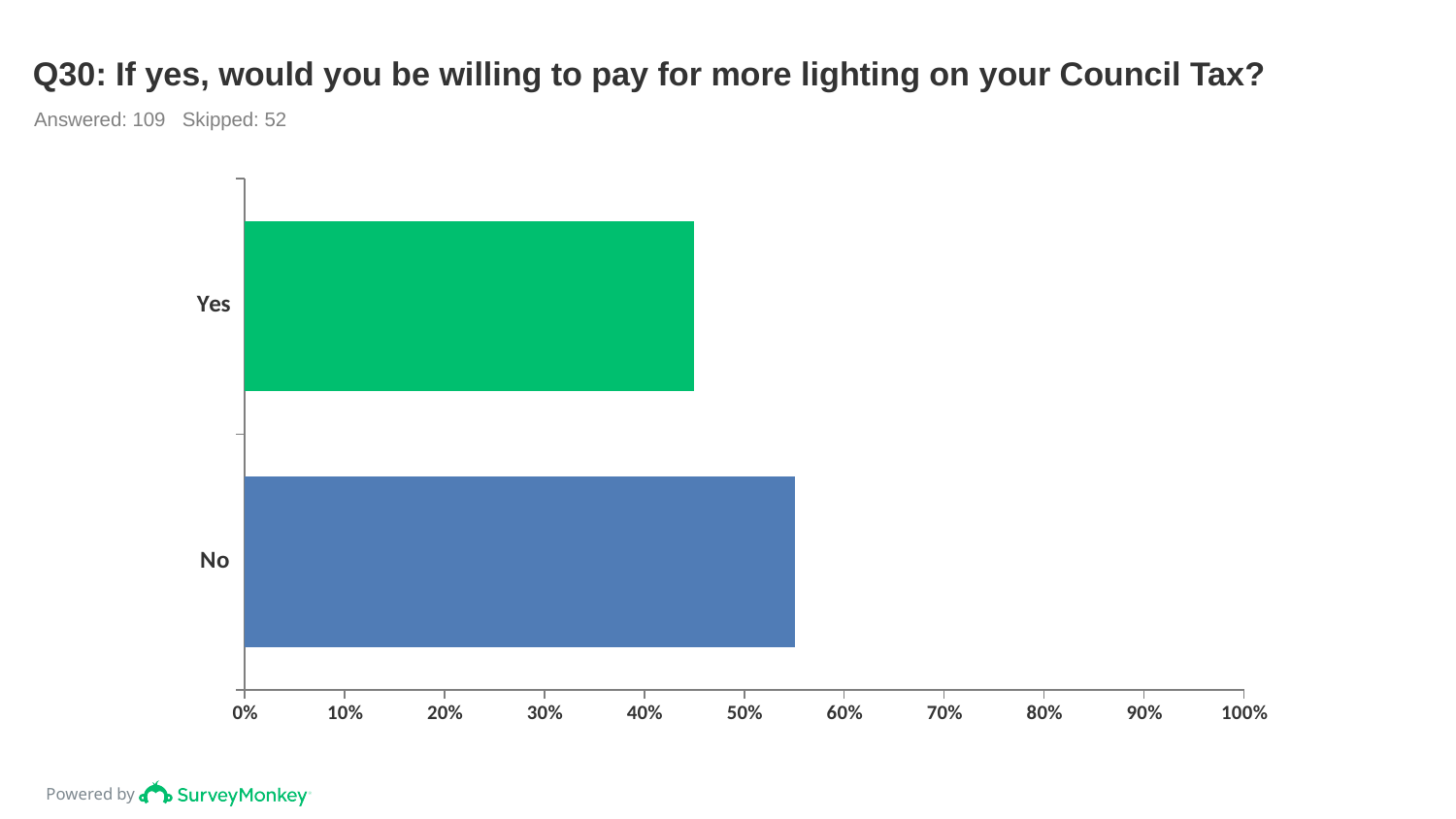
Which category has the lowest value? Yes How many categories are plotted in the chart? 2 Is the value for Yes greater or less than 40%? greater How many respondents answered the question according to the slide? 109 Is the value for No greater or less than 60%? less What kind of chart is shown on the slide? bar chart What is the title of the chart? Q30: If yes, would you be willing to pay for more lighting on your Council Tax? Is the value for No greater or less than 50%? greater Which is larger, the value for Yes or the value for No? No Which category has the highest value? No